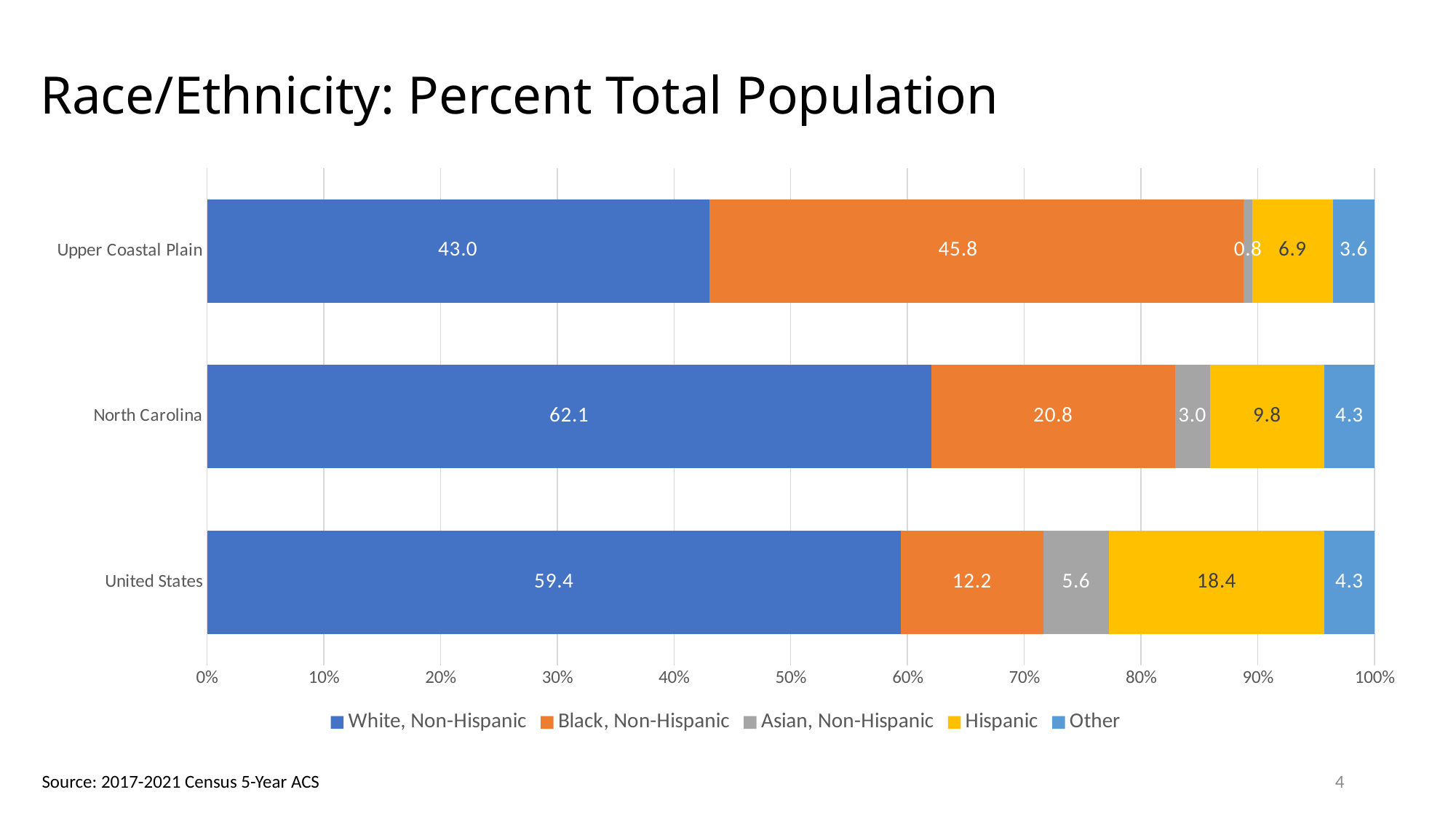
What is the White, Non-Hispanic value for Upper Coastal Plain? 43.0 For Upper Coastal Plain, which is larger: the White, Non-Hispanic value or the Black, Non-Hispanic value? Black, Non-Hispanic Which category has the highest White, Non-Hispanic value? North Carolina How many categories (geographic areas) are shown on the chart? 3 What is the Hispanic value for the United States? 18.4 What is the difference between the Hispanic values for the United States and Upper Coastal Plain? 11.5 Which category has the lowest Asian, Non-Hispanic value? Upper Coastal Plain What is the Asian, Non-Hispanic value for North Carolina? 3.0 What kind of chart is shown on the slide? Stacked bar chart What is the title of the chart? Race/Ethnicity: Percent Total Population What is the difference between the Black, Non-Hispanic values for Upper Coastal Plain and the United States? 33.6 How many series does the legend list? 5